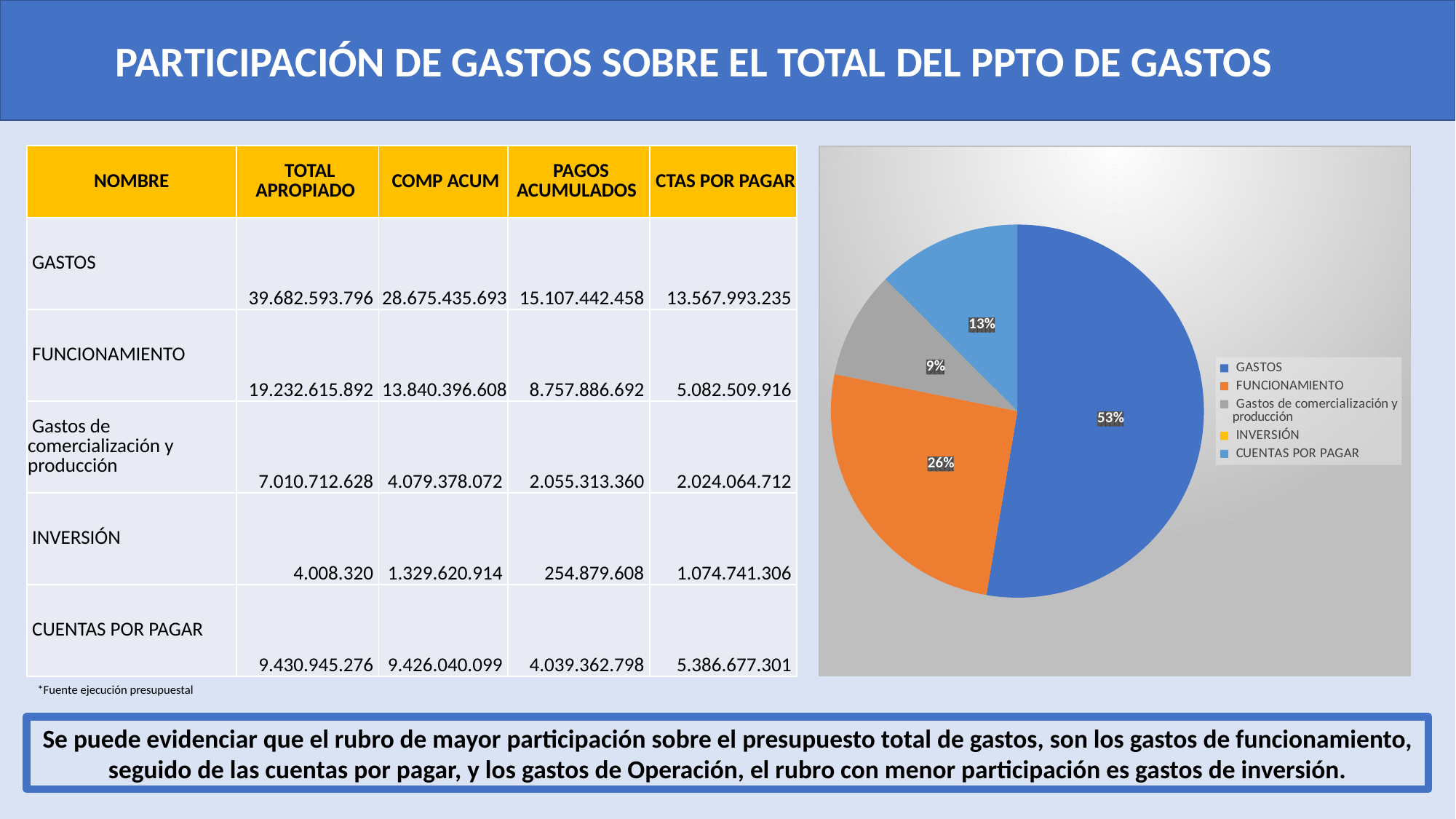
In the pie chart, what share is shown for GASTOS? 53% In the pie chart, which slice is larger: FUNCIONAMIENTO or CUENTAS POR PAGAR? FUNCIONAMIENTO In the pie chart, what share is shown for Gastos de comercialización y producción? 9% How many entries does the pie chart legend list? 5 What kind of chart is shown on the right of the slide? pie chart What colour is the FUNCIONAMIENTO slice in the pie chart? orange What is the difference in percentage points between the GASTOS slice and the FUNCIONAMIENTO slice in the pie chart? 27 In the pie chart, what share is shown for FUNCIONAMIENTO? 26% Which of the labelled slices in the pie chart is the smallest? Gastos de comercialización y producción Which category has the largest slice in the pie chart? GASTOS What colour is the GASTOS slice in the pie chart? blue